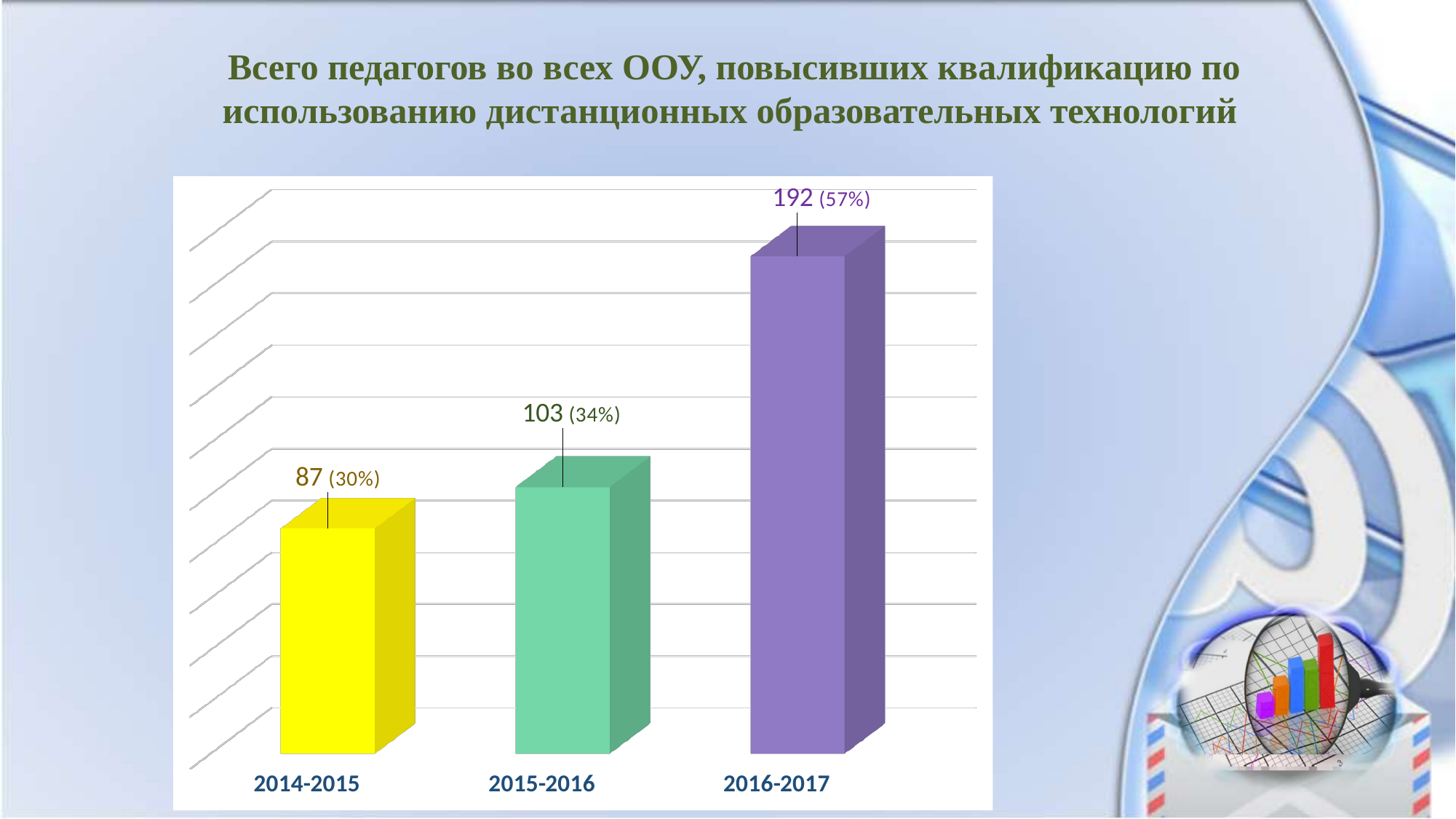
How many periods are shown on the x axis? 3 Which period has the highest value? 2016-2017 What colour is the bar for 2016-2017? purple What is the difference between the values for 2015-2016 and 2014-2015? 16 What is the difference between the values for 2016-2017 and 2015-2016? 89 Do the values rise or fall from 2014-2015 to 2016-2017? rise What is the value for 2014-2015? 87 (30%) Which period has the lowest value? 2014-2015 Which is larger, the value for 2015-2016 or the value for 2014-2015? 2015-2016 What is the value for 2016-2017? 192 (57%) What is the value for 2015-2016? 103 (34%) What kind of chart is shown on the slide? bar chart